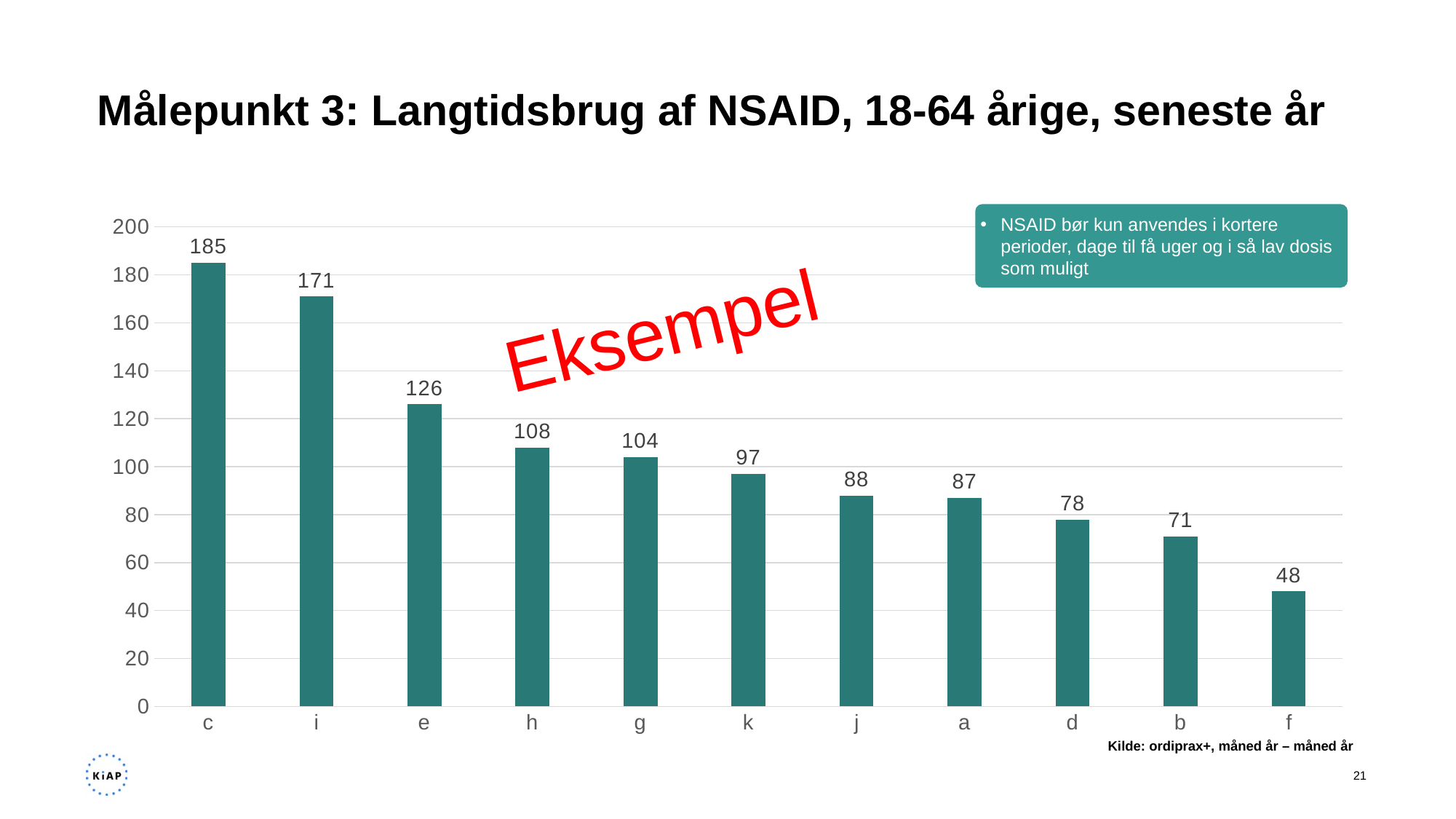
What kind of chart is shown on the slide? bar chart What is the value for category g? 104 What is the value for category c? 185 What is the value for category f? 48 Which is larger, the value for k or the value for d? k What is the difference between the values for c and i? 14 Which category has the lowest value? f How many categories are shown on the x axis? 11 Which category has the highest value? c Do the values rise or fall from left to right along the x axis? fall Is the value for b greater or less than 80? less What is the difference between the values for e and h? 18